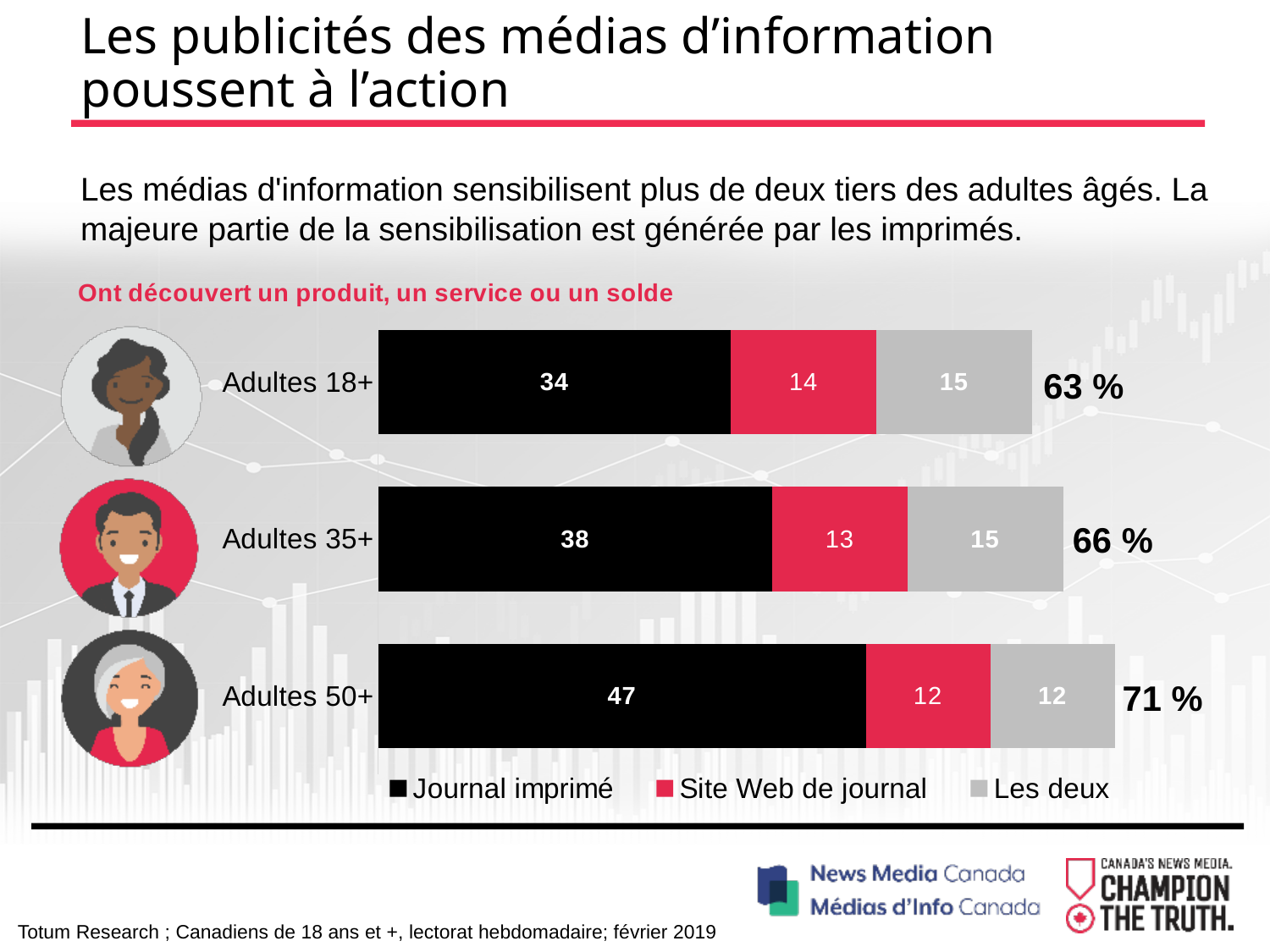
How many age groups are shown in the chart? 3 What is the value for Site Web de journal for Adultes 35+? 13 Which age group has the lowest value for Site Web de journal? Adultes 50+ What kind of chart is shown on the slide? Stacked bar chart What is the value for Les deux for Adultes 50+? 12 Which is larger: the Journal imprimé value for Adultes 35+ or for Adultes 18+? Adultes 35+ How many series does the legend list? 3 What is the total shown for the Adultes 50+ bar? 71 % Which age group has the highest value for Journal imprimé? Adultes 50+ What is the value for Journal imprimé for Adultes 18+? 34 What is the difference between the Journal imprimé values for Adultes 50+ and Adultes 18+? 13 What is the total shown for the Adultes 18+ bar? 63 %